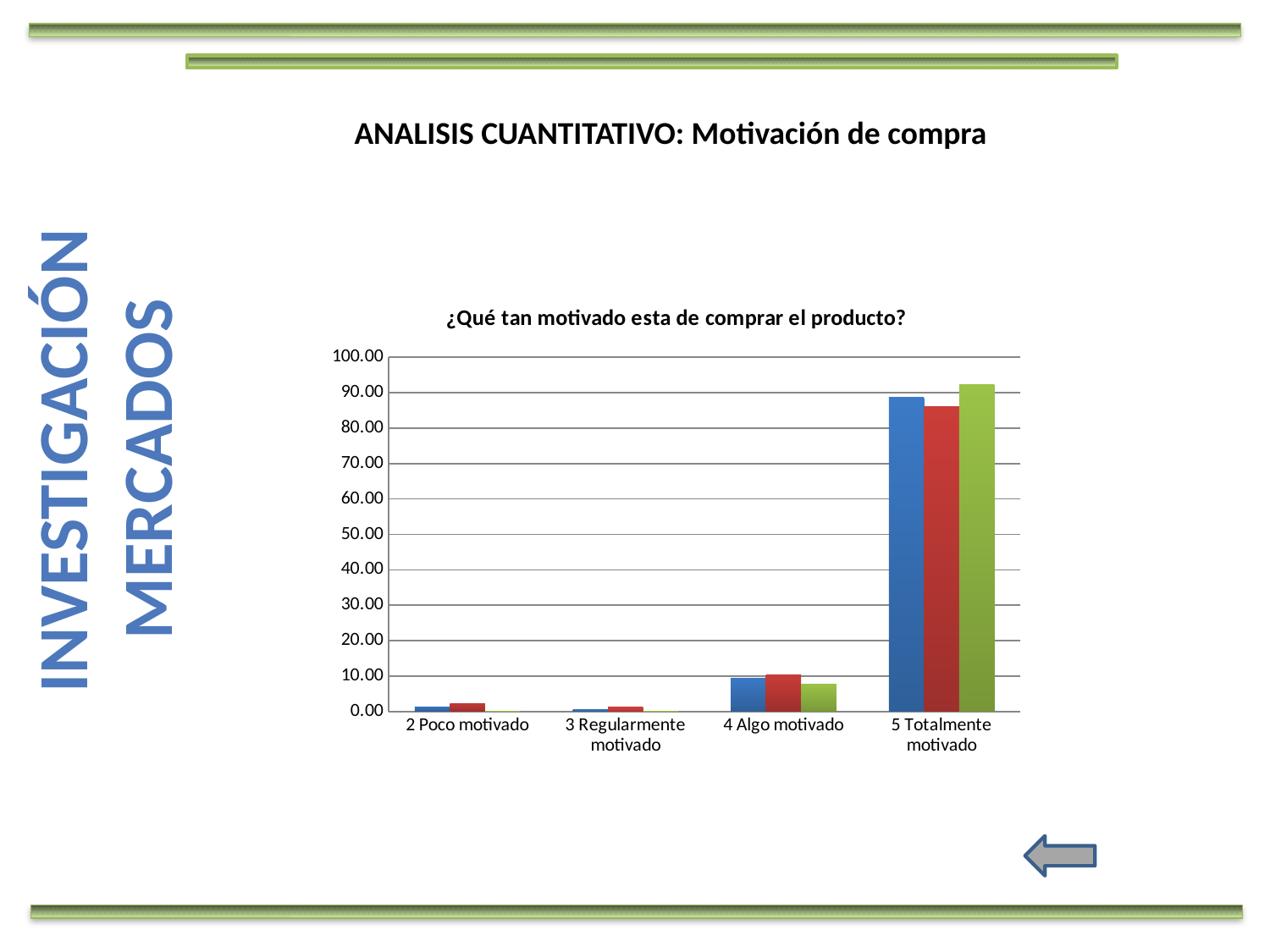
Which is larger for 4 Algo motivado, the red bar or the green bar? the red bar Which is larger for 5 Totalmente motivado, the blue bar or the green bar? the green bar How many bars are plotted for each category in the chart? 3 Which category has the highest values in the chart? 5 Totalmente motivado How many categories are shown on the x axis of the chart? 4 What kind of chart is shown on the slide? bar chart Is the value of the blue bar for 4 Algo motivado greater or less than 20.00? less Is the value of the green bar for 5 Totalmente motivado greater or less than 90.00? greater Which category has the lowest values in the chart? 3 Regularmente motivado Is the value of the red bar for 5 Totalmente motivado greater or less than 90.00? less Do the values generally rise or fall from 3 Regularmente motivado to 5 Totalmente motivado along the x axis? rise What is the title of the chart? ¿Qué tan motivado esta de comprar el producto?